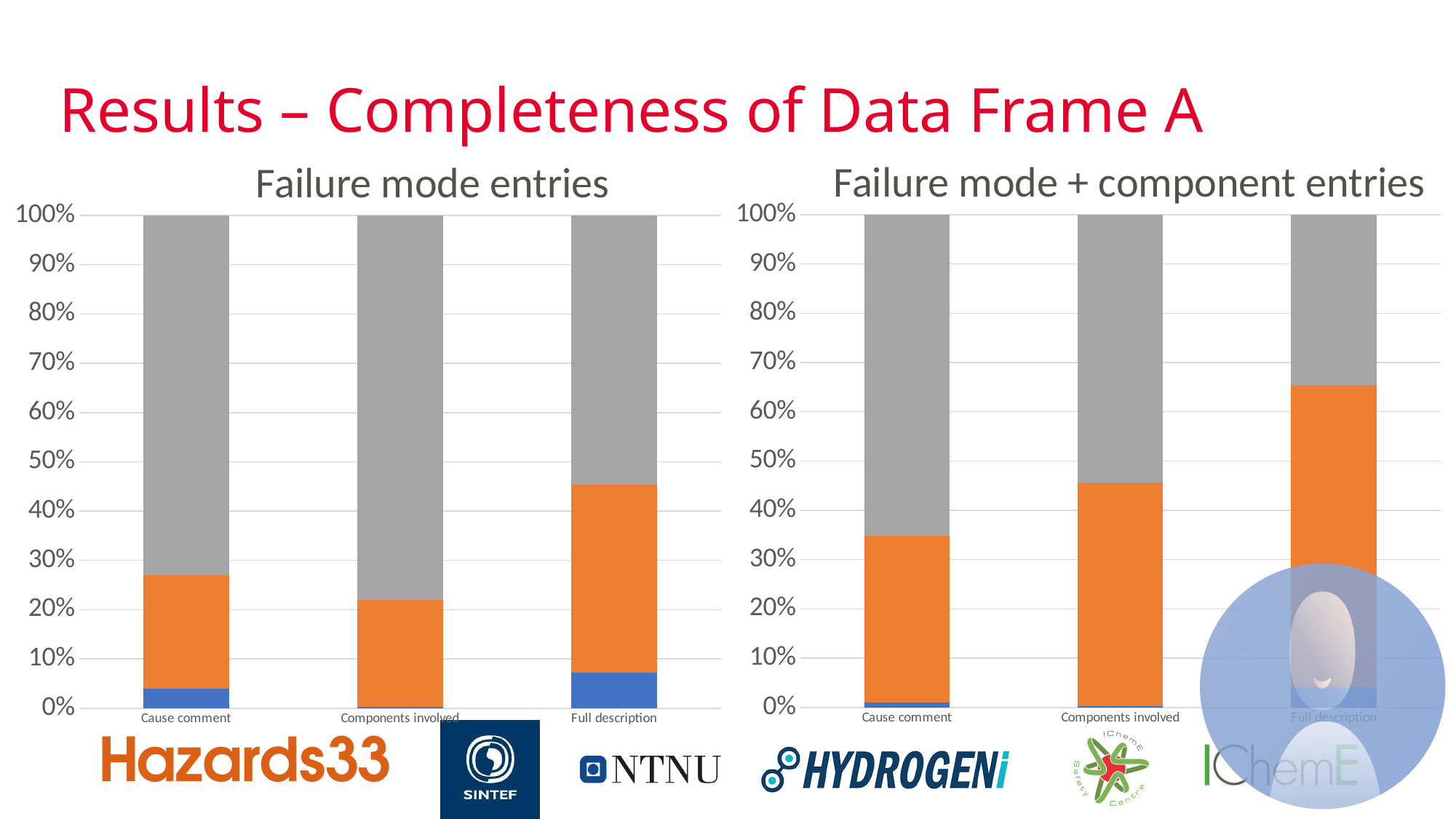
In the "Failure mode + component entries" chart, is the top of the orange segment for Full description greater or less than 60%? greater How many categories are shown on the x axis of the "Failure mode + component entries" chart? 3 In the "Failure mode + component entries" chart, is the top of the orange segment for Cause comment greater or less than 40%? less What is the title of the chart on the right side of the slide? Failure mode + component entries In the "Failure mode entries" chart, what is the total height of the stacked bar for Cause comment? 100% What kind of chart is the "Failure mode entries" chart? Stacked bar chart In the "Failure mode + component entries" chart, is the orange segment larger for Components involved or for Cause comment? Components involved In the "Failure mode entries" chart, which category has the largest orange segment? Full description In the "Failure mode + component entries" chart, does the top of the orange segment rise or fall from Cause comment to Full description? rise In the "Failure mode entries" chart, is the top of the orange segment for Cause comment greater or less than 30%? less In the "Failure mode + component entries" chart, which category has the largest gray segment? Cause comment